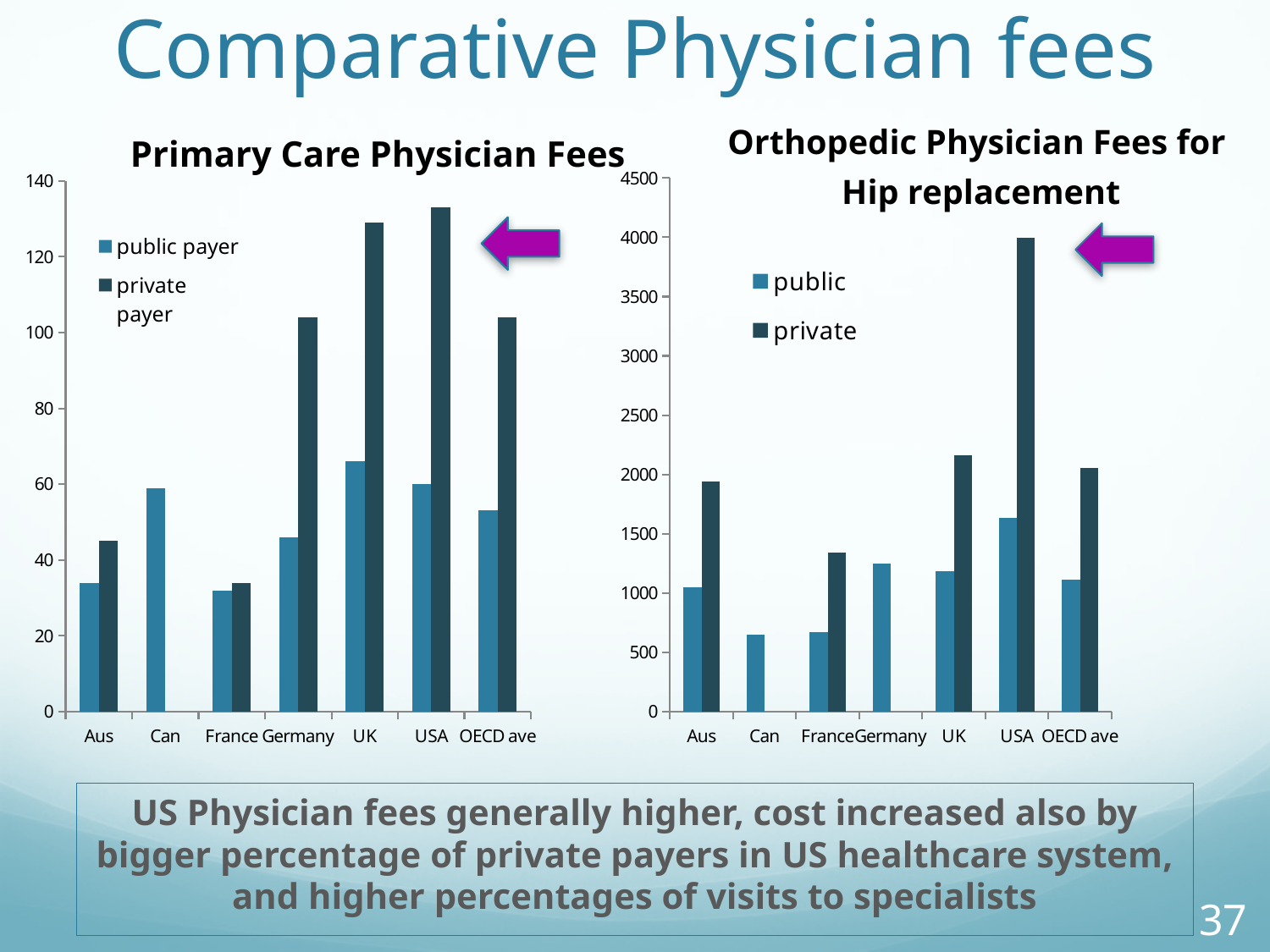
In the Primary Care Physician Fees chart, is the public payer value for Aus greater or less than 40? less In the Primary Care Physician Fees chart, which is larger, the private payer value for Germany or for France? Germany In the Orthopedic Physician Fees for Hip replacement chart, is the public value for Can greater or less than 1000? less In the Primary Care Physician Fees chart, is the private payer value for UK greater or less than 120? greater In the Primary Care Physician Fees chart, how many categories are shown on the x axis? 7 In the Orthopedic Physician Fees for Hip replacement chart, which is larger, the private value for UK or for Aus? UK In the Primary Care Physician Fees chart, which category has the highest public payer value? UK In the Primary Care Physician Fees chart, what kind of chart is used? bar chart In the Orthopedic Physician Fees for Hip replacement chart, which category has the highest private value? USA In the Primary Care Physician Fees chart, how many series does the legend list? 2 In the Orthopedic Physician Fees for Hip replacement chart, what are the two legend entries? public, private